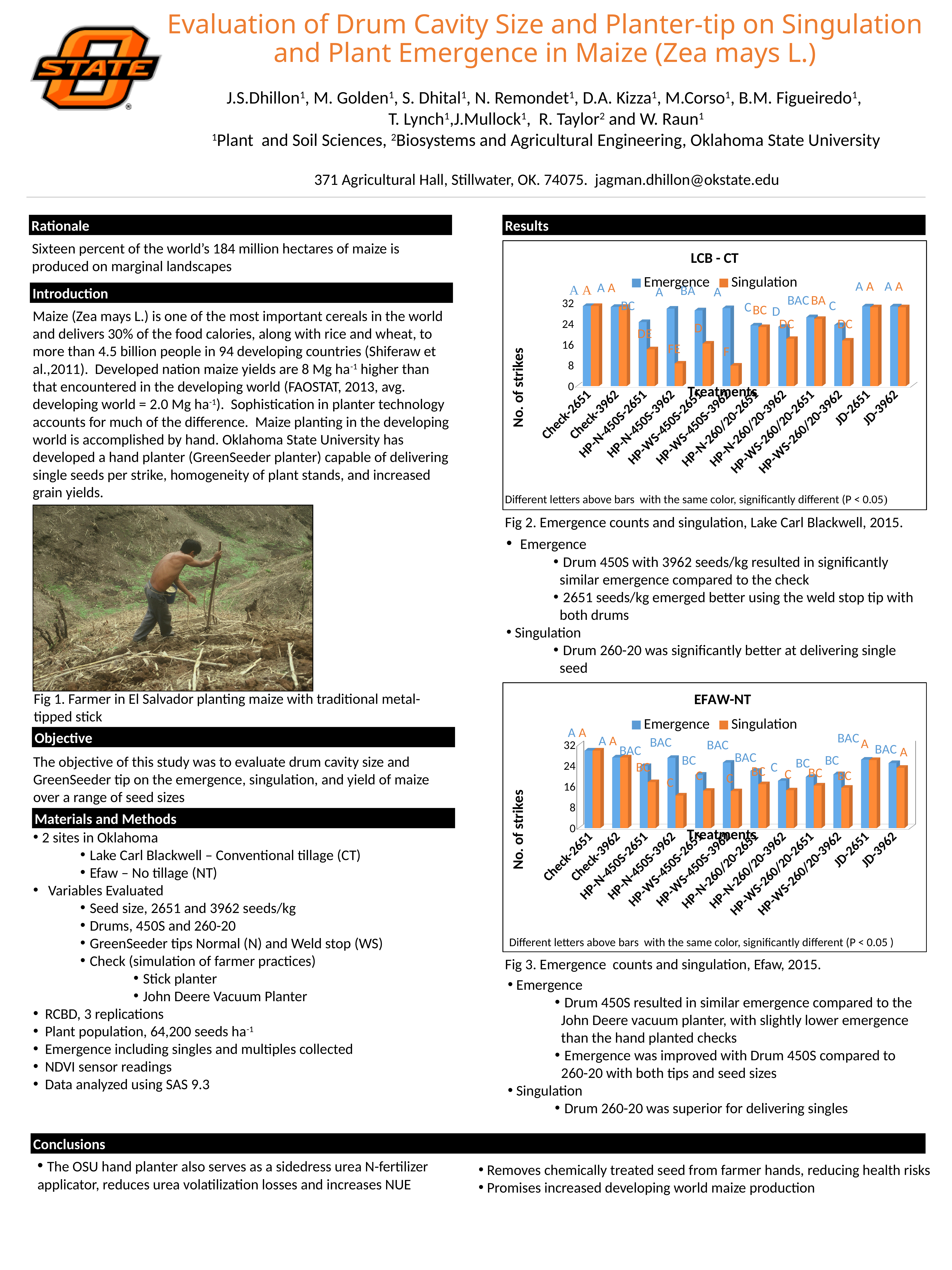
How many series does the legend of the LCB - CT chart list? 2 In the LCB - CT chart, is the Emergence value for JD-2651 greater or less than 24? greater In the EFAW-NT chart, is the Singulation value for HP-N-450S-3962 greater or less than 16? less In the EFAW-NT chart, is the Emergence value for HP-N-260/20-3962 greater or less than 24? less In the LCB - CT chart, which colour represents the Singulation series? orange In the EFAW-NT chart, which is larger for HP-WS-450S-3962, Emergence or Singulation? Emergence What kind of chart is the LCB - CT chart? bar chart In the LCB - CT chart, which is larger for HP-N-450S-3962, Emergence or Singulation? Emergence What is the y-axis title of the EFAW-NT chart? No. of strikes How many treatment categories are shown on the x axis of the EFAW-NT chart? 12